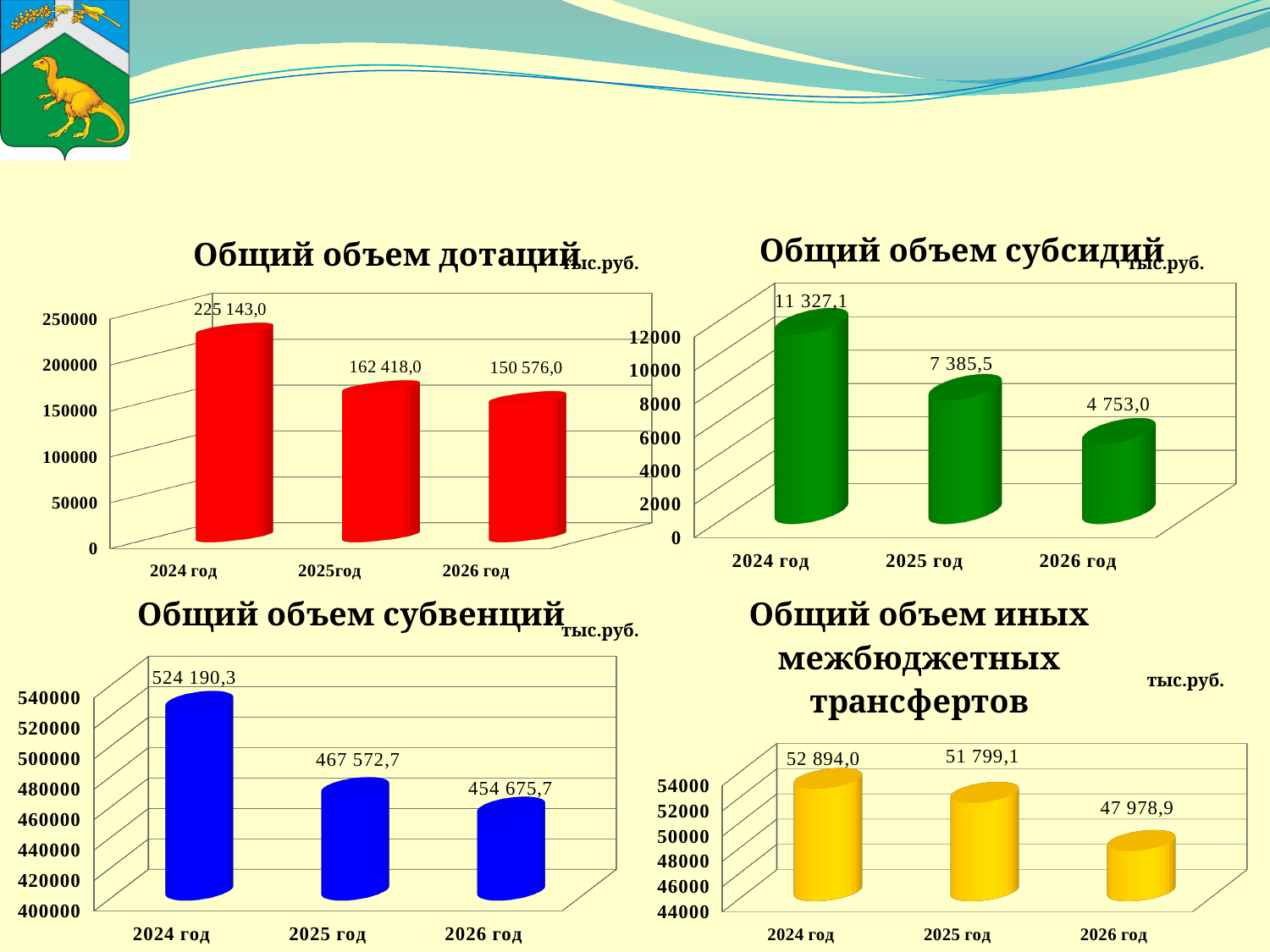
In the chart titled "Общий объем иных межбюджетных трансфертов", what is the difference between the values for 2024 год and 2026 год? 4 915,1 How many categories (years) are shown in the chart titled "Общий объем дотаций"? 3 In the chart titled "Общий объем субвенций", which year has the highest value? 2024 год In the chart titled "Общий объем дотаций", what is the difference between the values for 2024 год and 2025 год? 62 725,0 In the chart titled "Общий объем субсидий", which is larger: the value for 2024 год or 2025 год? 2024 год In the chart titled "Общий объем субсидий", which year has the lowest value? 2026 год In the chart titled "Общий объем субсидий", what is the value for 2026 год? 4 753,0 In the chart titled "Общий объем иных межбюджетных трансфертов", what is the value for 2026 год? 47 978,9 In the chart titled "Общий объем дотаций", what is the value for 2024 год? 225 143,0 In the chart titled "Общий объем субвенций", do the values rise or fall from 2024 год to 2026 год? fall In the chart titled "Общий объем субвенций", what is the value for 2025 год? 467 572,7 What kind of chart is the chart titled "Общий объем иных межбюджетных трансфертов"? bar chart